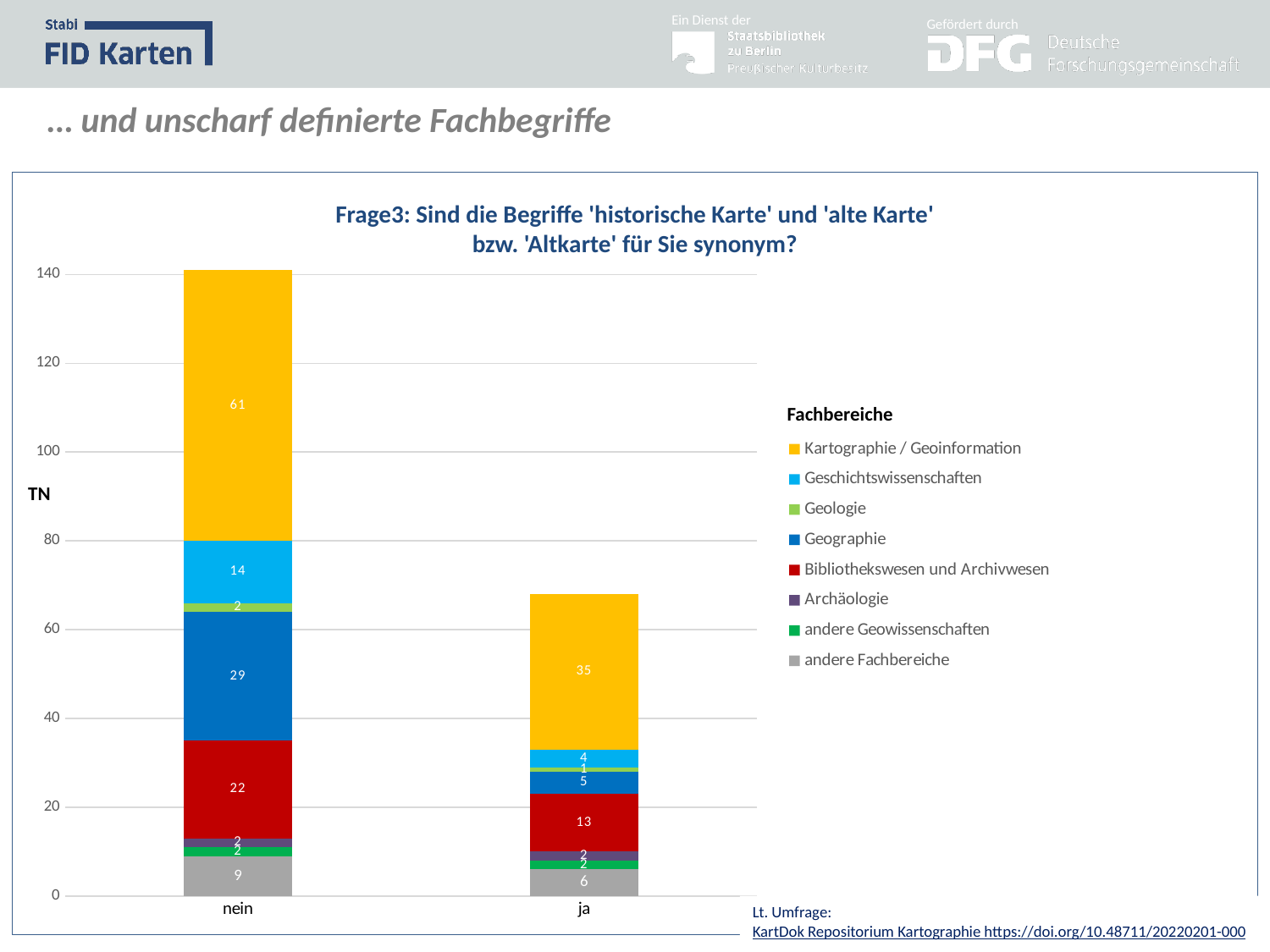
Is the total height of the 'ja' bar greater or less than 60? greater What kind of chart is shown on the slide? stacked bar chart What is the value for andere Fachbereiche in the 'ja' bar? 6 What is the value for Kartographie / Geoinformation in the 'nein' bar? 61 How many series does the legend list? 8 What is the difference between the Kartographie / Geoinformation values for 'nein' and 'ja'? 26 How many categories are shown on the x axis? 2 Which category has the taller stacked bar overall? nein Which category has the larger Geschichtswissenschaften value, 'nein' or 'ja'? nein What is the difference between the Bibliothekswesen und Archivwesen values for 'nein' and 'ja'? 9 What is the value for Bibliothekswesen und Archivwesen in the 'nein' bar? 22 What is the value for Geographie in the 'ja' bar? 5